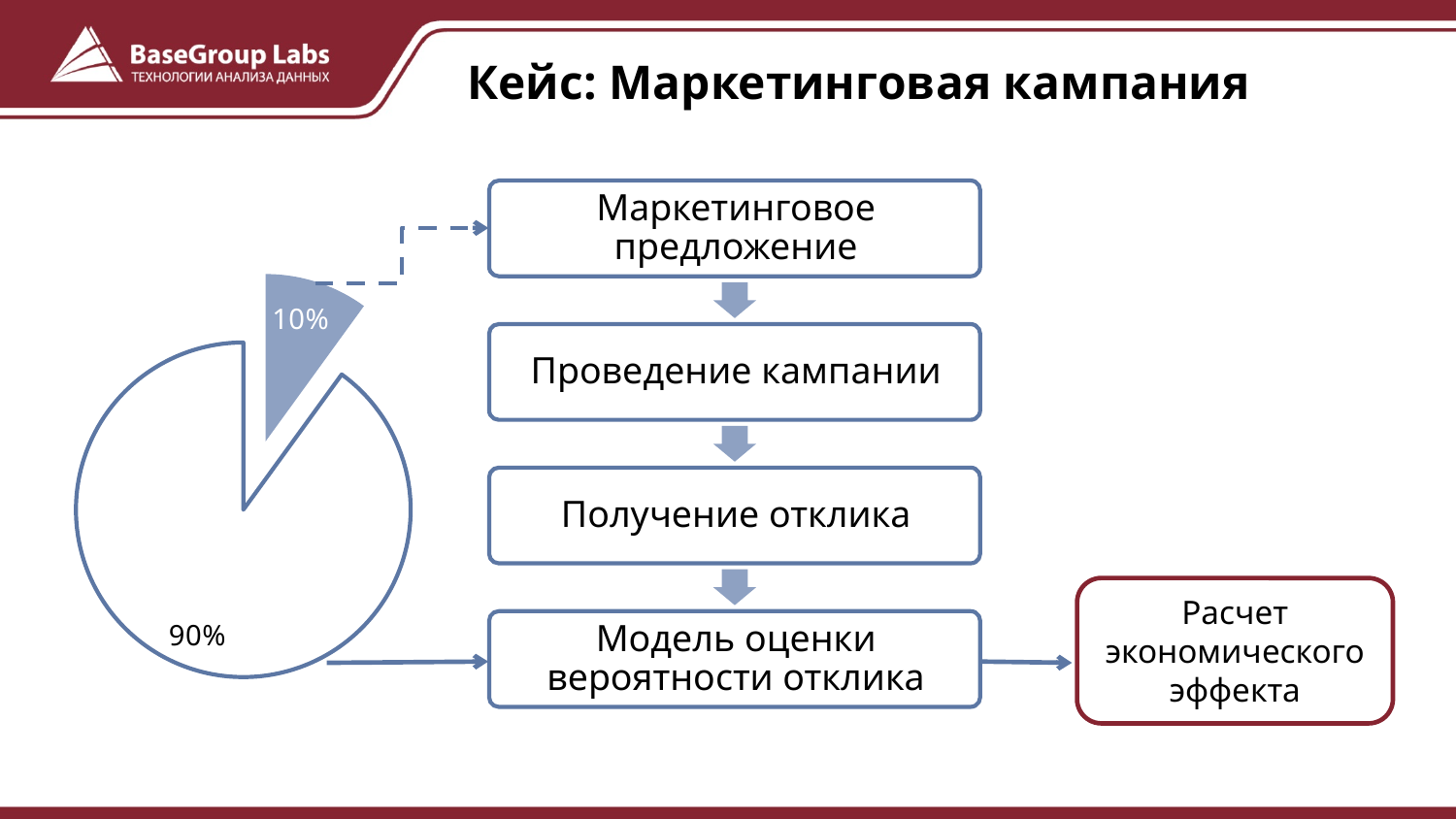
What is the difference between the two slices of the pie chart? 80 percentage points What share of the pie does the larger slice represent? 90% How many slices does the pie chart have? 2 Which slice of the pie chart is the largest? 90% What kind of chart is shown on the left of the slide? pie chart Is the value of the blue-filled slice greater or less than 50%? less Which is larger in the pie chart, the blue-filled slice or the white slice? the white slice What share of the pie does the smaller, exploded slice represent? 10% Which slice of the pie chart is pulled out (exploded) from the rest of the pie? the 10% slice Which slice of the pie chart is the smallest? 10% What is the value printed on the white slice of the pie chart? 90% What is the value printed on the blue-filled slice of the pie chart? 10%